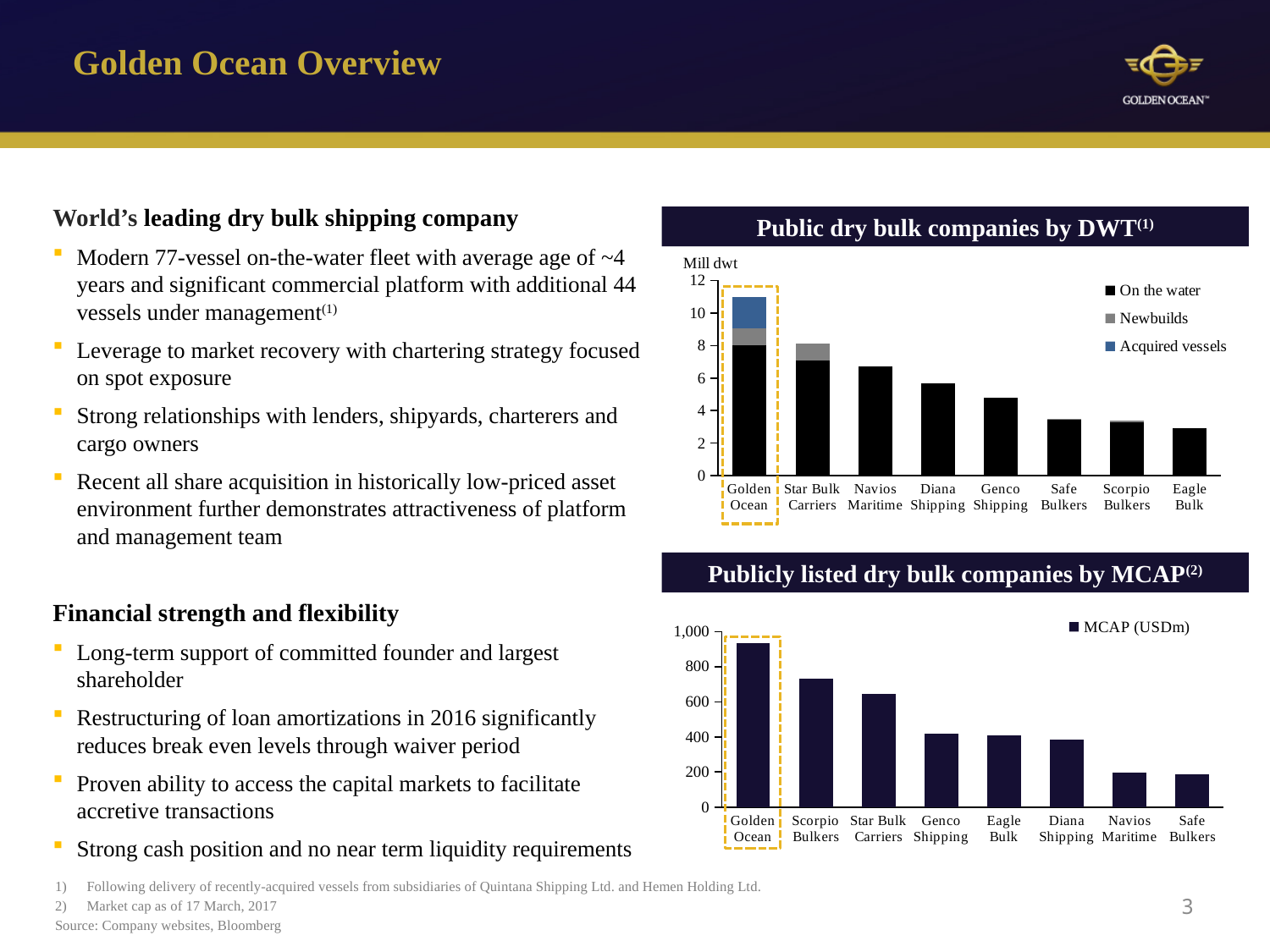
In the 'Publicly listed dry bulk companies by MCAP' chart, is the value for Golden Ocean greater or less than 800? greater In the 'Publicly listed dry bulk companies by MCAP' chart, is the value for Navios Maritime greater or less than 400? less In the 'Public dry bulk companies by DWT' chart, how many series does the legend list? 3 In the 'Publicly listed dry bulk companies by MCAP' chart, how many companies are shown? 8 In the 'Public dry bulk companies by DWT' chart, which company has the highest total DWT? Golden Ocean In the 'Publicly listed dry bulk companies by MCAP' chart, which company has the highest market cap? Golden Ocean In the 'Public dry bulk companies by DWT' chart, which is larger, Navios Maritime or Genco Shipping? Navios Maritime What kind of chart is the 'Publicly listed dry bulk companies by MCAP' chart? Bar chart In the 'Public dry bulk companies by DWT' chart, which company has the lowest DWT? Eagle Bulk In the 'Public dry bulk companies by DWT' chart, is the total value for Golden Ocean greater or less than 10? greater In the 'Public dry bulk companies by DWT' chart, which series is shown in blue? Acquired vessels